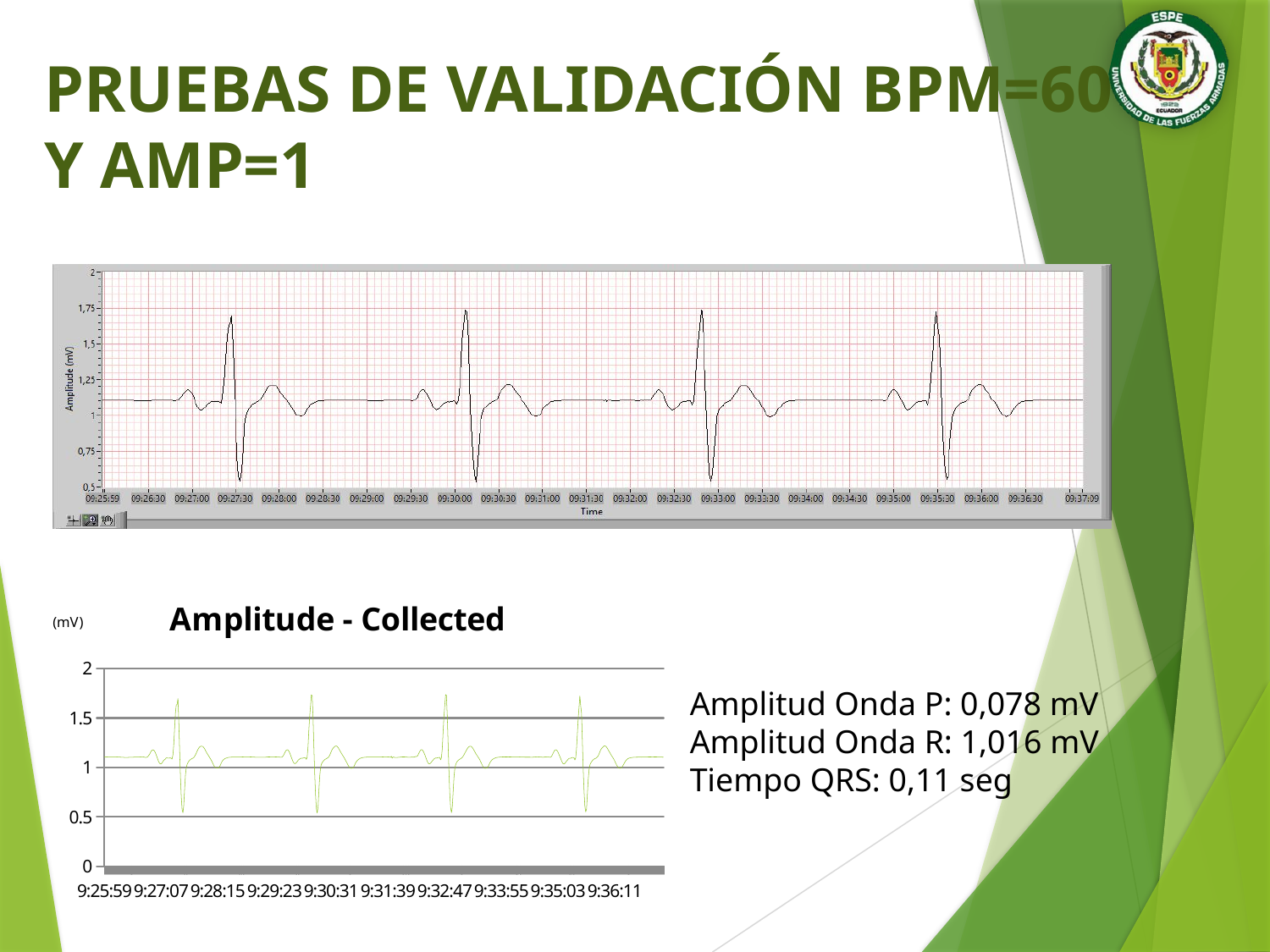
What is the last time label on the x axis of the 'Amplitude - Collected' chart? 9:36:11 In the 'Amplitude - Collected' chart, how many large R-wave peaks are plotted? 4 What kind of chart is the 'Amplitude - Collected' chart at the bottom of the slide? line chart In the 'Amplitude - Collected' chart, is the height of each large peak greater or less than 1.5? greater What is the maximum value shown on the y axis of the 'Amplitude - Collected' chart? 2 What is the y-axis label of the top chart on the slide? Amplitude (mV) In the top chart, is the height of each large upward spike greater or less than 1.5? greater In the top chart, how many large upward spikes are plotted? 4 What is the title of the chart at the bottom of the slide? Amplitude - Collected In the 'Amplitude - Collected' chart, is the lowest point of each downward spike greater or less than 1? less What is the first time label on the x axis of the 'Amplitude - Collected' chart? 9:25:59